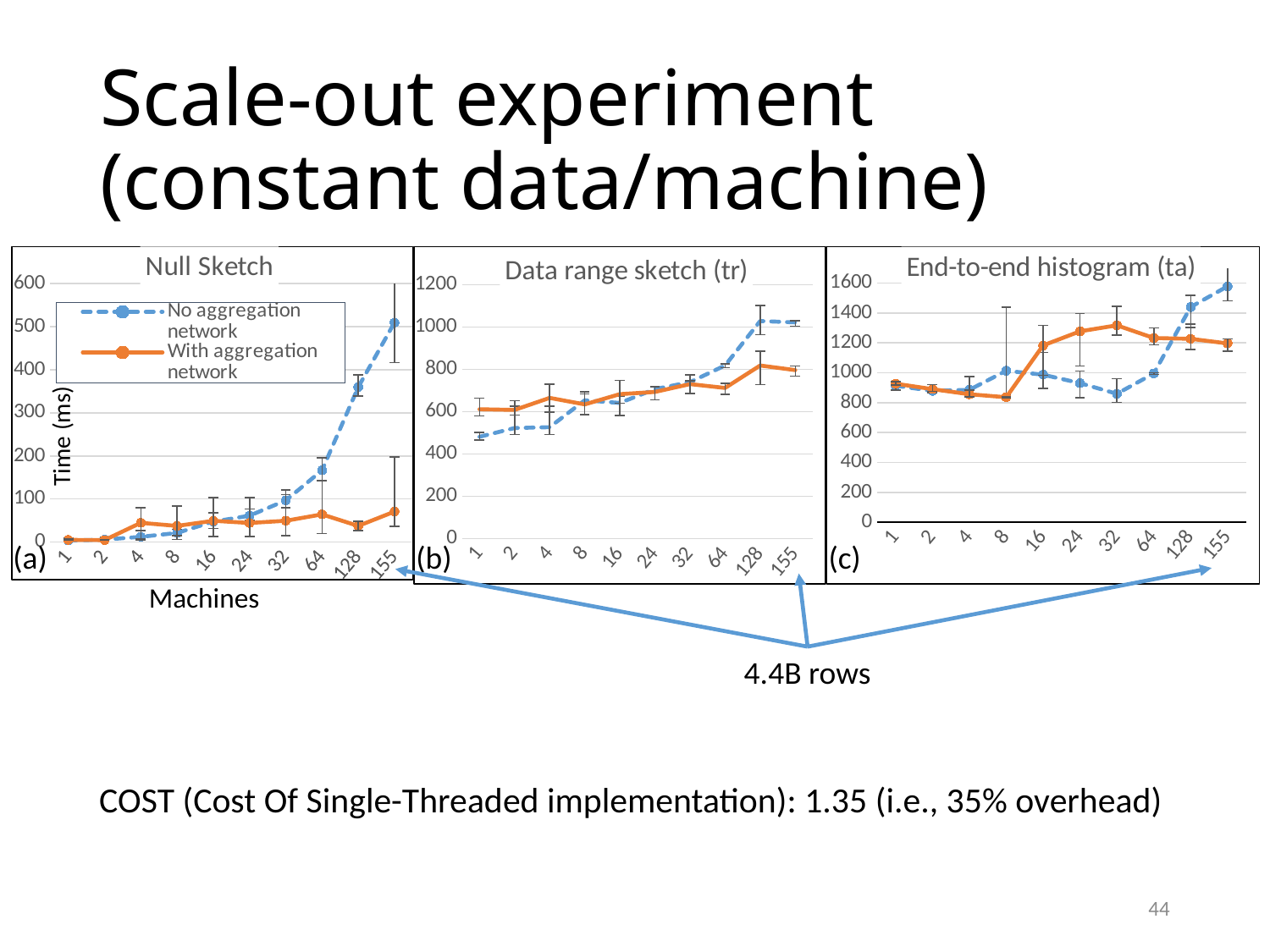
In the Null Sketch chart, which series has the larger value at 155 machines, No aggregation network or With aggregation network? No aggregation network How many series does the legend of the Null Sketch chart list? 2 In the Null Sketch chart, does the No aggregation network series generally rise or fall as the number of machines increases? rise What kind of chart is the Null Sketch chart? line chart In the Data range sketch (tr) chart, which series has the larger value at 155 machines, No aggregation network or With aggregation network? No aggregation network In the End-to-end histogram (ta) chart, at which number of machines does the No aggregation network series reach its highest value? 155 In the Null Sketch chart, is the value for With aggregation network at 155 machines greater or less than 100? less In the End-to-end histogram (ta) chart, is the value for No aggregation network at 155 machines greater or less than 1400? greater What is the y-axis label of the Null Sketch chart? Time (ms) How many machine counts are plotted along the x axis of the Null Sketch chart? 10 In the Null Sketch chart, is the value for No aggregation network at 155 machines greater or less than 400? greater